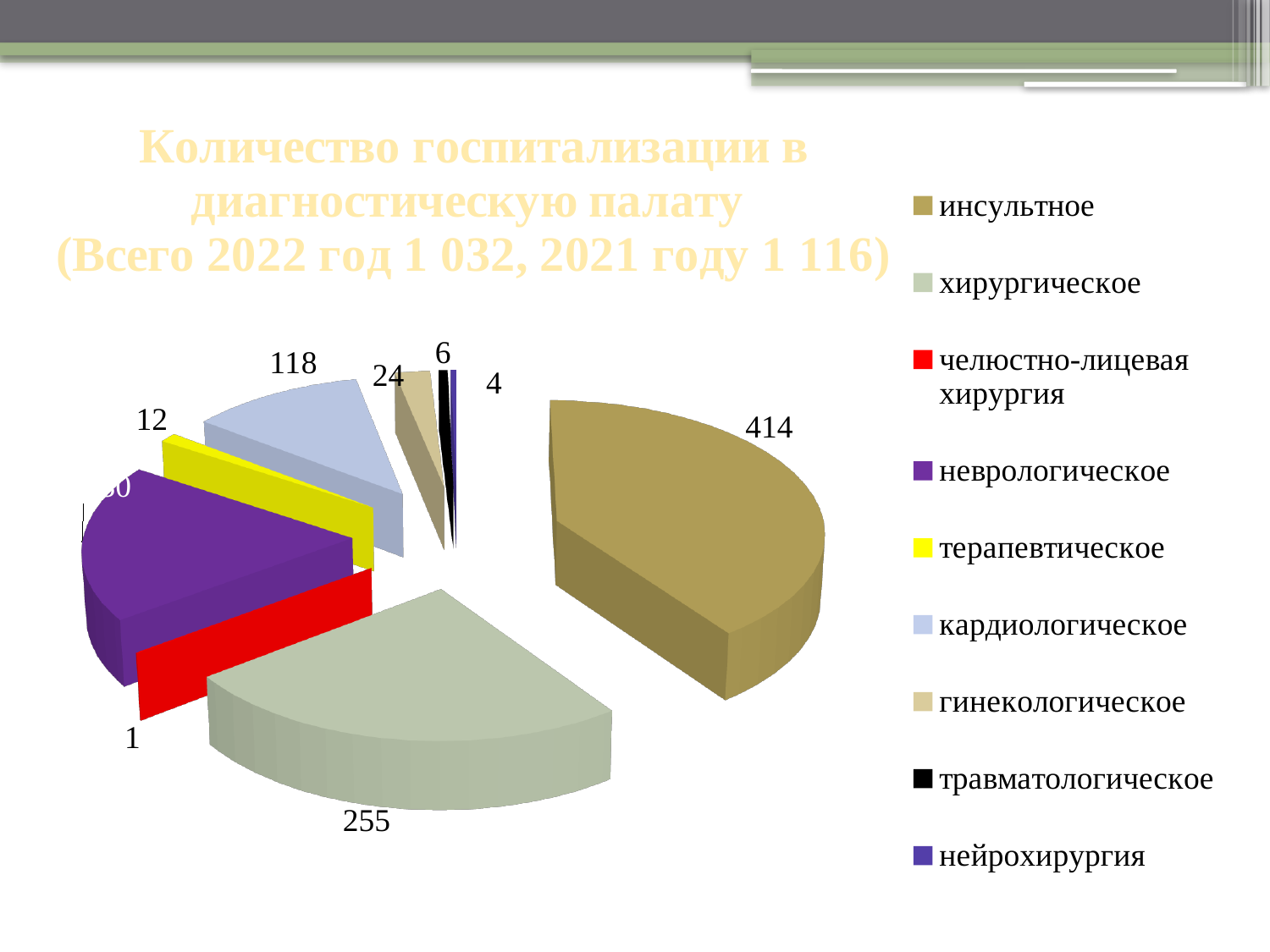
What is the value for кардиологическое? 118 Which is larger, the value for кардиологическое or the value for гинекологическое? кардиологическое What is the value for нейрохирургия? 4 How many categories does the legend list? 9 Which category has the largest slice of the pie? инсультное What is the value for инсультное? 414 What is the difference between the values for инсультное and хирургическое? 159 What is the value for хирургическое? 255 What is the value for терапевтическое? 12 What is the value for гинекологическое? 24 What type of chart is shown on the slide? pie chart What is the value for травматологическое? 6